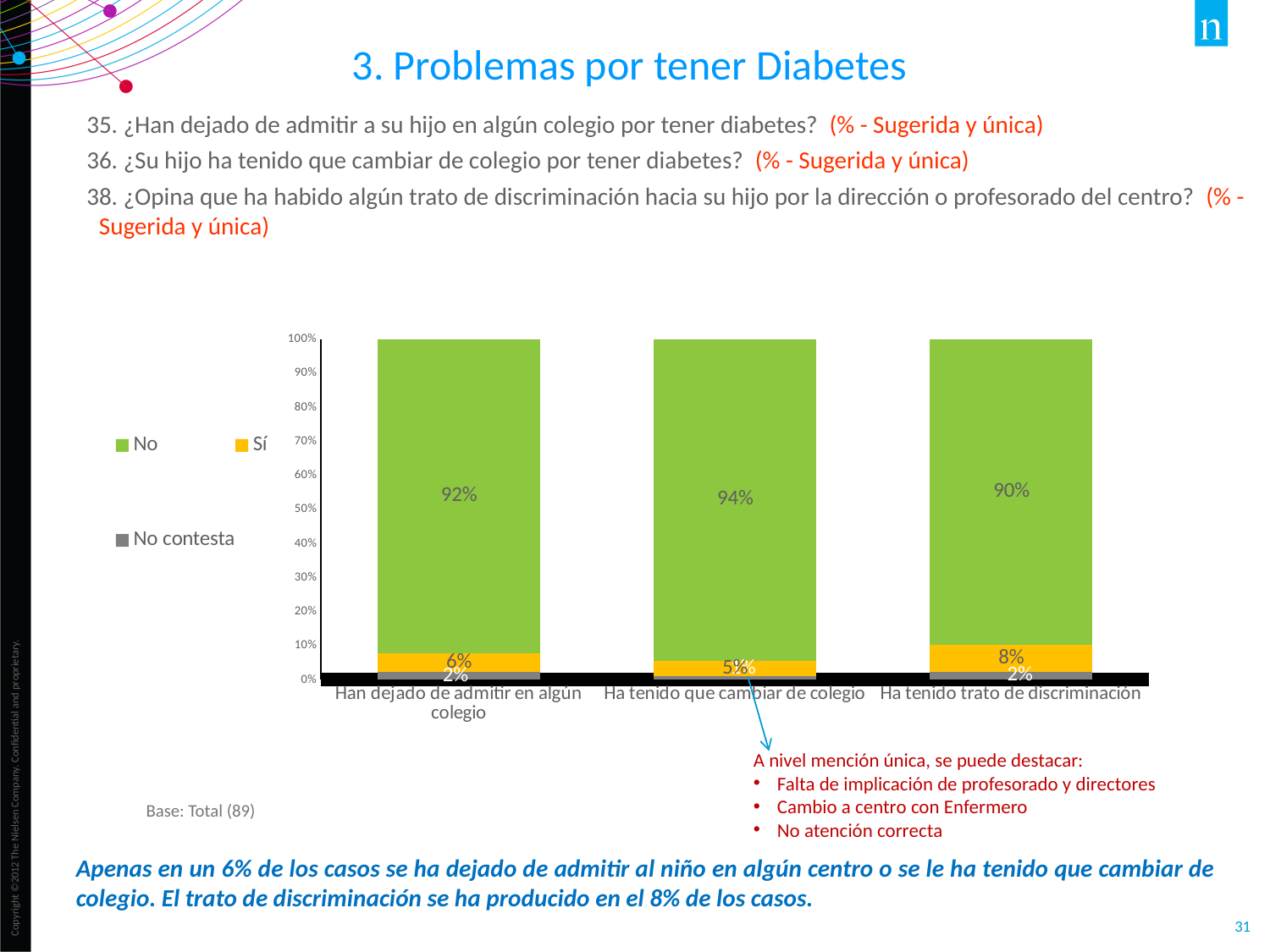
Which category has the lowest "Sí" percentage? Ha tenido que cambiar de colegio Which is larger: the "Sí" value for "Ha tenido trato de discriminación" or for "Han dejado de admitir en algún colegio"? Ha tenido trato de discriminación What percentage answered "Sí" for "Han dejado de admitir en algún colegio"? 6% What kind of chart is shown on the slide? Stacked bar chart What is the difference between the "No" percentages for "Ha tenido que cambiar de colegio" and "Ha tenido trato de discriminación"? 4% What percentage answered "Sí" for "Ha tenido trato de discriminación"? 8% What percentage answered "No" for "Ha tenido que cambiar de colegio"? 94% Which colour represents the "Sí" series in the chart? Yellow What is the "No contesta" value for "Han dejado de admitir en algún colegio"? 2% How many series does the chart legend list? 3 Which category has the highest "No" percentage? Ha tenido que cambiar de colegio How many categories are shown on the x axis of the chart? 3